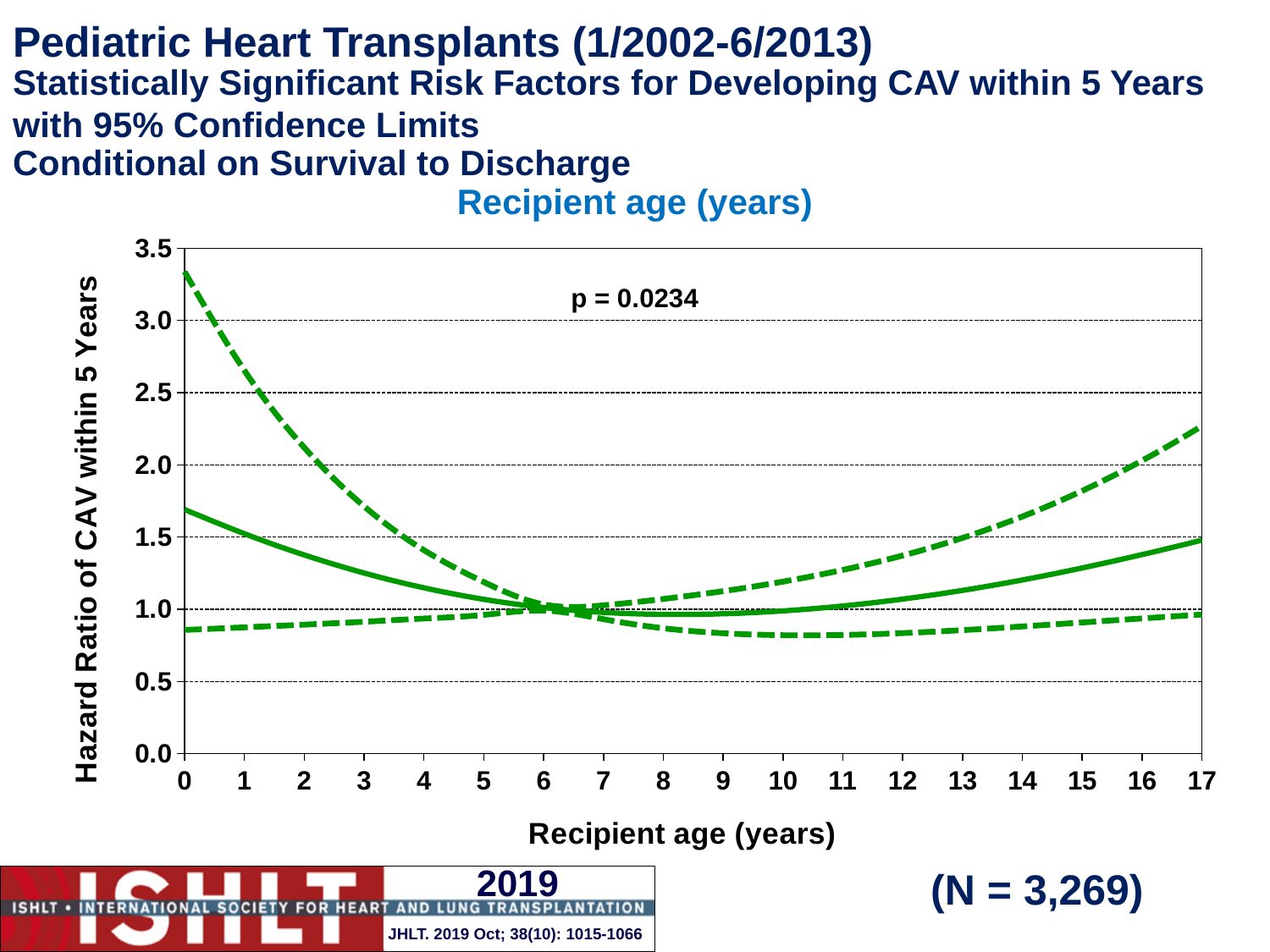
Is the value of the upper dashed confidence limit at recipient age 17 greater or less than 2.0? greater What kind of chart is shown on the slide? Line chart What is the highest value shown on the y axis? 3.5 Does the solid hazard ratio line rise or fall as recipient age increases from 0 to 6 years? fall Is the value of the lower dashed confidence limit at recipient age 10 greater or less than 1.0? less What is the p-value printed on the chart? p = 0.0234 Is the value of the solid hazard ratio line at recipient age 0 greater or less than 1.5? greater What is the sample size (N) shown on the slide? N = 3,269 How many lines are plotted on the chart? 3 Does the solid hazard ratio line rise or fall as recipient age increases from 10 to 17 years? rise